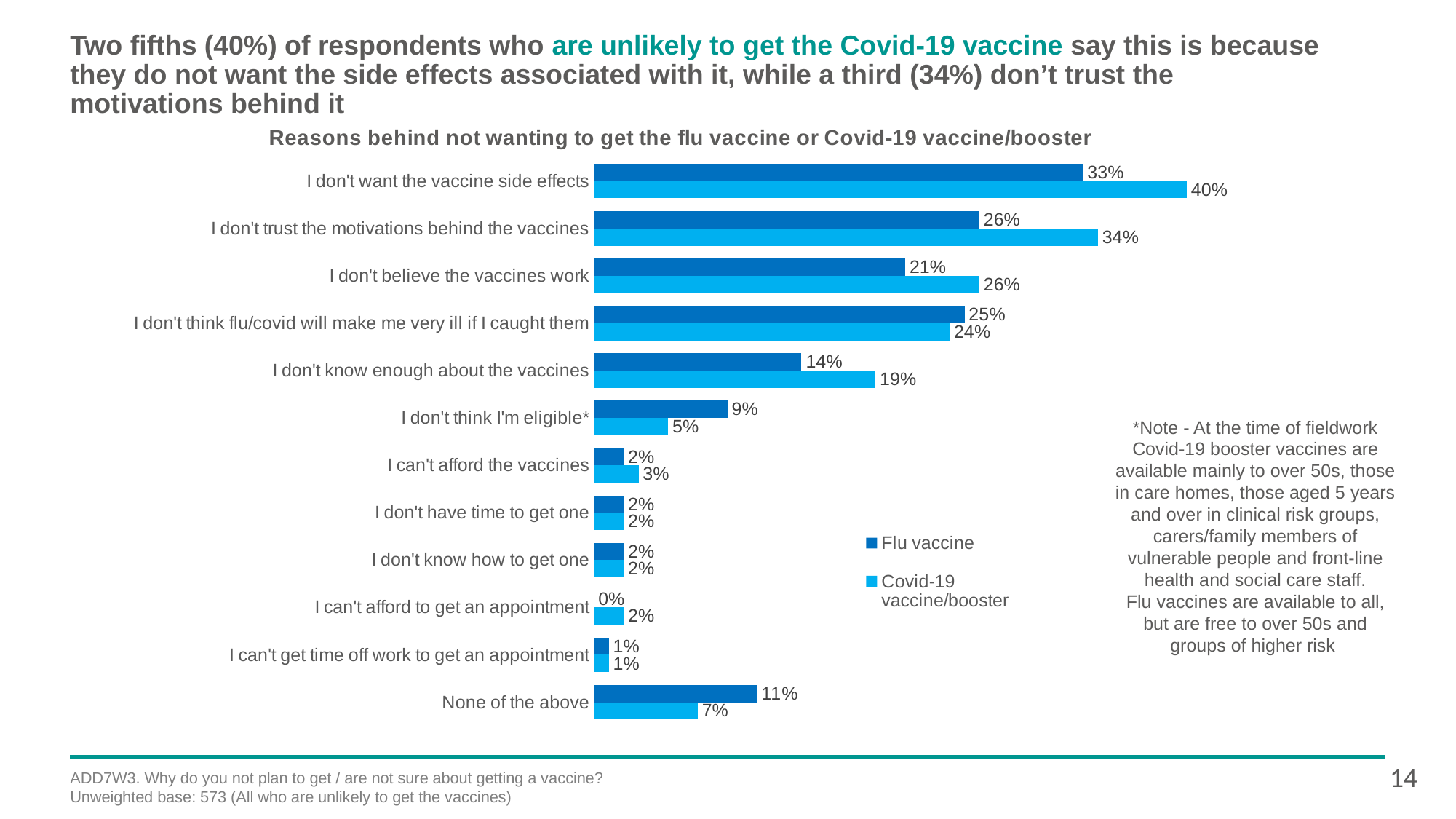
What percentage of respondents gave 'I don't want the vaccine side effects' as a reason for the Covid-19 vaccine/booster? 40% Which reason has the lowest Flu vaccine value? I can't afford to get an appointment How many series does the legend list? 2 What type of chart is shown on the slide? Bar chart For 'I don't think I'm eligible*', which series has the larger value, Flu vaccine or Covid-19 vaccine/booster? Flu vaccine Which reason has the highest Covid-19 vaccine/booster value? I don't want the vaccine side effects What is the title of the chart? Reasons behind not wanting to get the flu vaccine or Covid-19 vaccine/booster What is the Flu vaccine value for 'I don't trust the motivations behind the vaccines'? 26% What is the difference between the Covid-19 vaccine/booster and Flu vaccine values for 'I don't believe the vaccines work'? 5% How many reason categories are shown on the chart? 12 For 'None of the above', which series has the larger value, Flu vaccine or Covid-19 vaccine/booster? Flu vaccine What is the Covid-19 vaccine/booster value for 'I don't know enough about the vaccines'? 19%